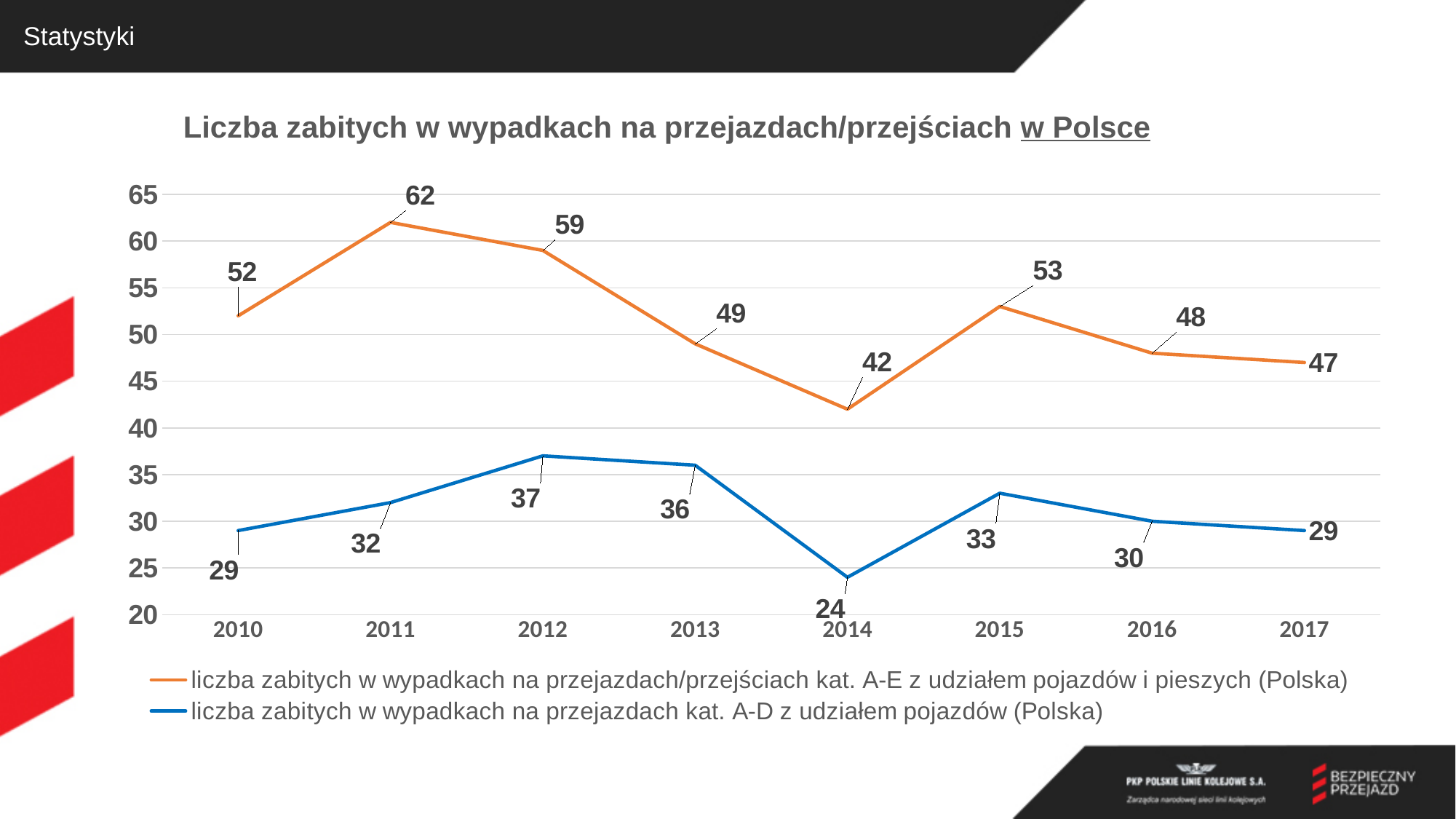
What is the difference between the orange series and the blue series in 2014? 18 What is the title of the chart? Liczba zabitych w wypadkach na przejazdach/przejściach w Polsce What is the value of the orange series (kat. A-E z udziałem pojazdów i pieszych) in 2011? 62 Does the orange series rise or fall from 2011 to 2014? fall How many years are shown on the x axis? 8 In which year is the orange series (kat. A-E) highest? 2011 What kind of chart is shown on the slide? line chart What is the value of the blue series (kat. A-D z udziałem pojazdów) in 2014? 24 What is the value of the orange series (kat. A-E) in 2017? 47 How many series does the legend list? 2 Which is larger: the blue series value in 2012 or in 2015? 2012 In which year is the blue series (kat. A-D) lowest? 2014